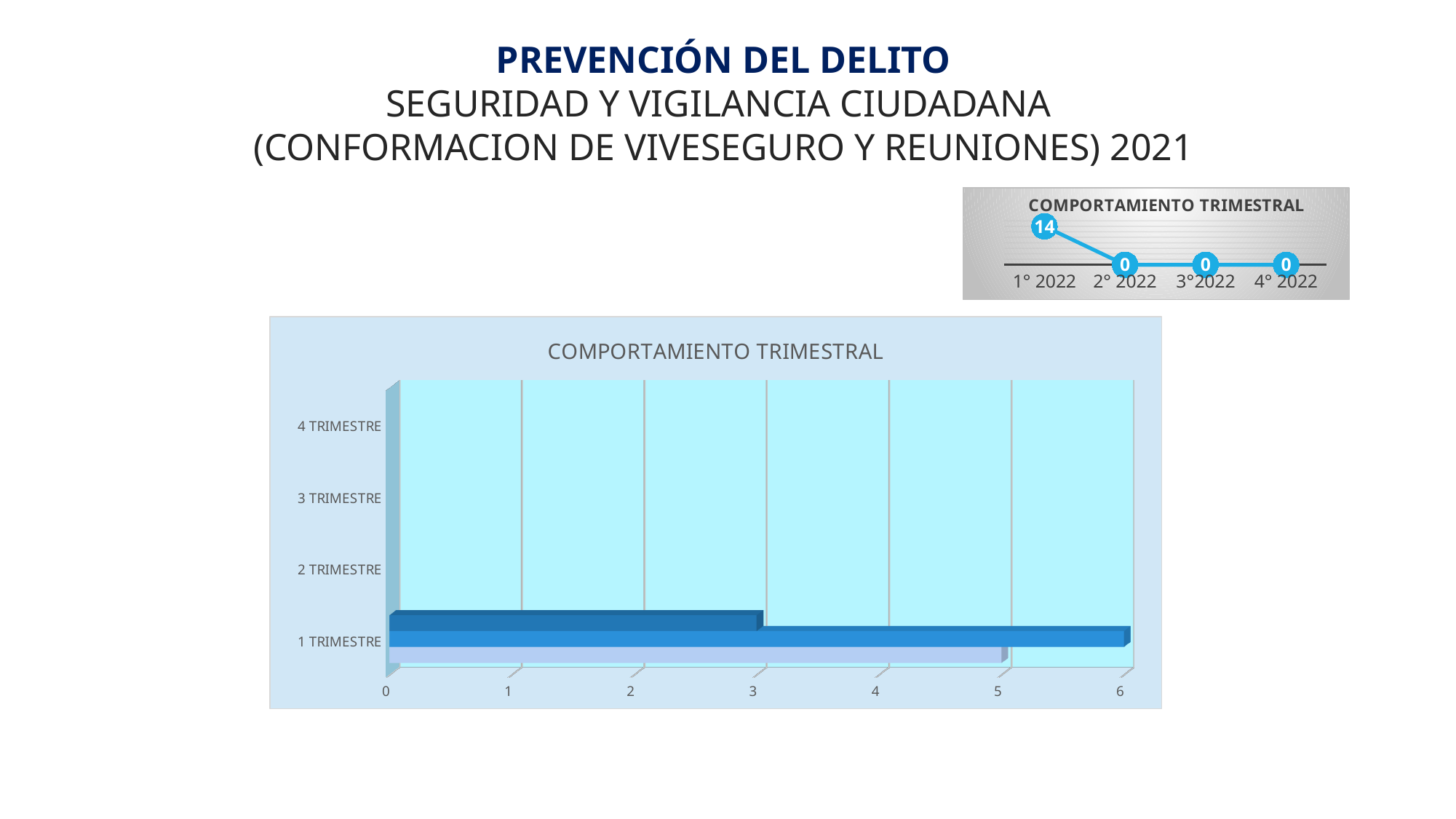
In the line chart at the top right, what is the value for 1° 2022? 14 In the large bar chart, is the longest bar for 1 TRIMESTRE greater or less than 5? greater What is the title of the large bar chart? COMPORTAMIENTO TRIMESTRAL How many data points are plotted in the line chart at the top right? 4 In the large bar chart, which category is the only one with visible bars? 1 TRIMESTRE How many categories are listed on the vertical axis of the large bar chart? 4 What type of chart is the large chart in the lower part of the slide? bar chart In the line chart at the top right, which quarter has the highest value? 1° 2022 In the line chart at the top right, what is the difference between the values for 1° 2022 and 2° 2022? 14 In the line chart at the top right, what is the value for 3°2022? 0 In the line chart at the top right, do the values rise or fall from 1° 2022 to 4° 2022? fall What type of chart is the small chart at the top right of the slide? line chart